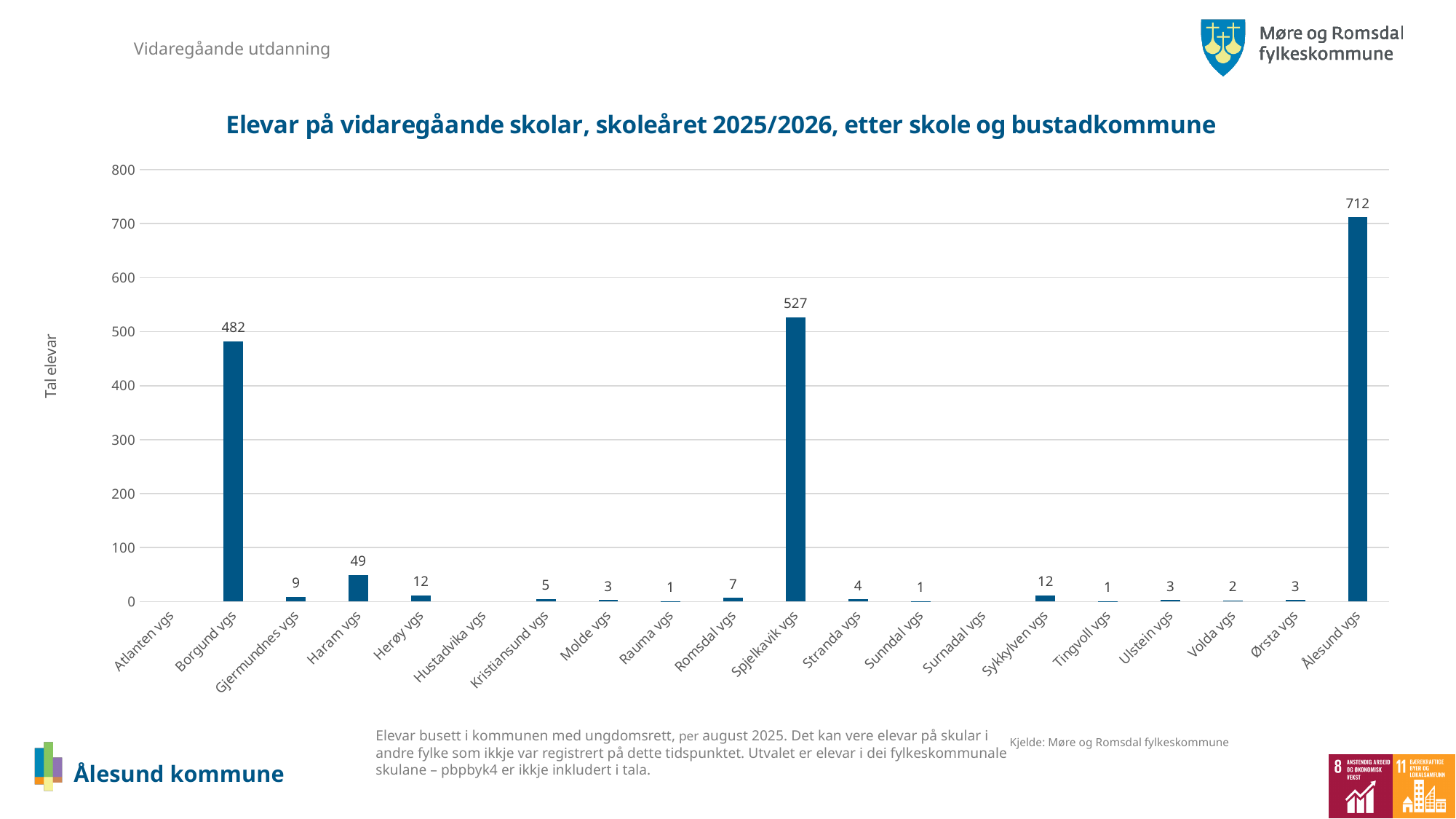
What is the difference between the values for Spjelkavik vgs and Borgund vgs? 45 What is the difference between the values for Ålesund vgs and Spjelkavik vgs? 185 What is the value for Borgund vgs? 482 What is the value for Ålesund vgs? 712 Which school has the highest number of students? Ålesund vgs What is the value for Herøy vgs? 12 Which is larger, the value for Borgund vgs or the value for Spjelkavik vgs? Spjelkavik vgs What is the value for Haram vgs? 49 What kind of chart is shown on the slide? bar chart Is the value for Borgund vgs greater or less than 400? greater What is the value for Spjelkavik vgs? 527 How many schools are shown on the x axis? 20